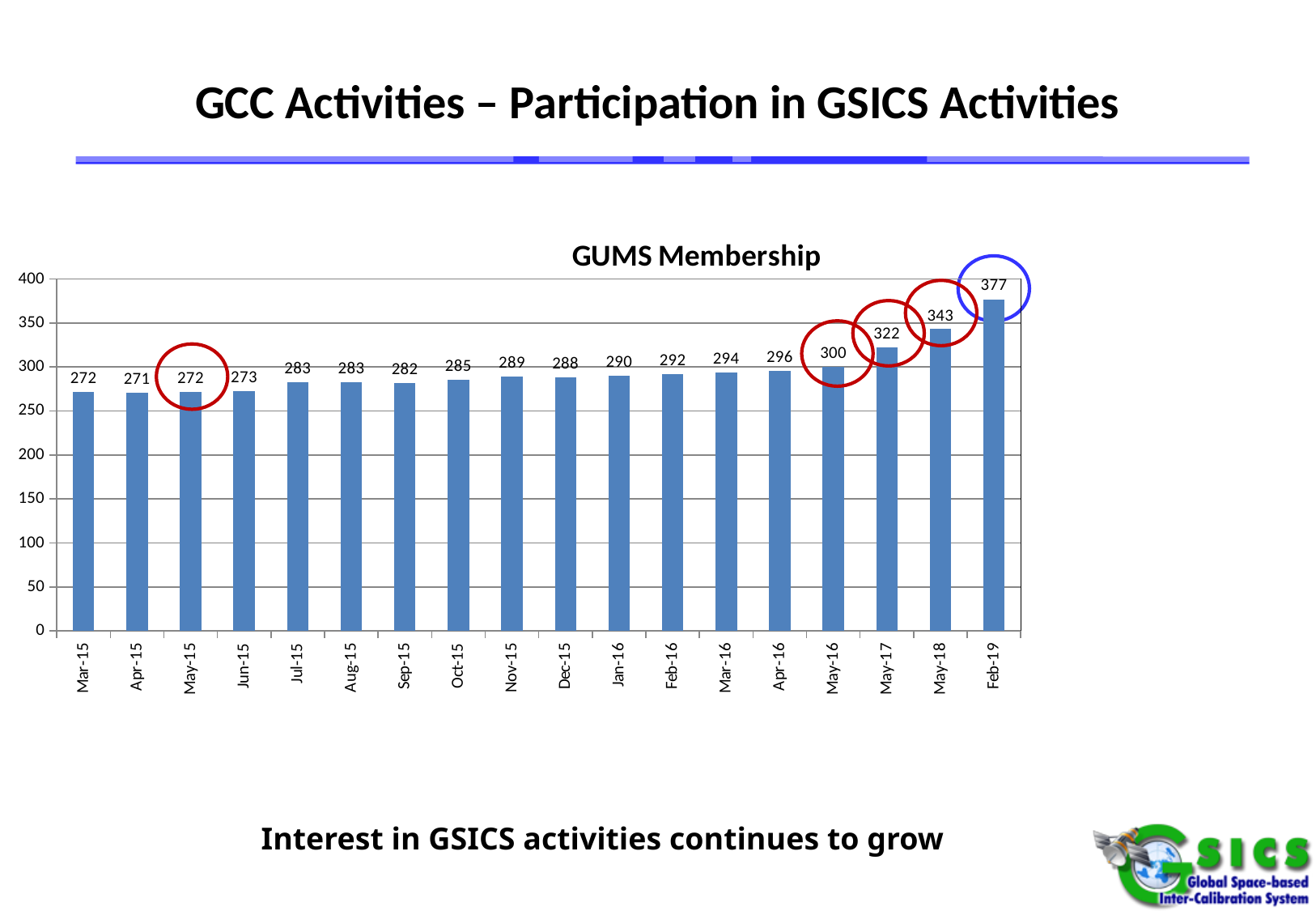
Do the GUMS membership values generally rise or fall from Mar-15 to Feb-19? rise What kind of chart is the GUMS Membership chart? bar chart Which category has the highest GUMS membership? Feb-19 What is the difference in GUMS membership between Feb-19 and May-18? 34 Which is larger, the GUMS membership for May-18 or for May-17? May-18 What is the GUMS membership value for Feb-19? 377 Which category has the lowest GUMS membership? Apr-15 What is the GUMS membership value for May-17? 322 Is the GUMS membership value for May-18 greater or less than 300? greater What is the GUMS membership value for Nov-15? 289 What is the difference in GUMS membership between May-16 and Mar-15? 28 How many categories are shown on the x axis of the GUMS Membership chart? 18